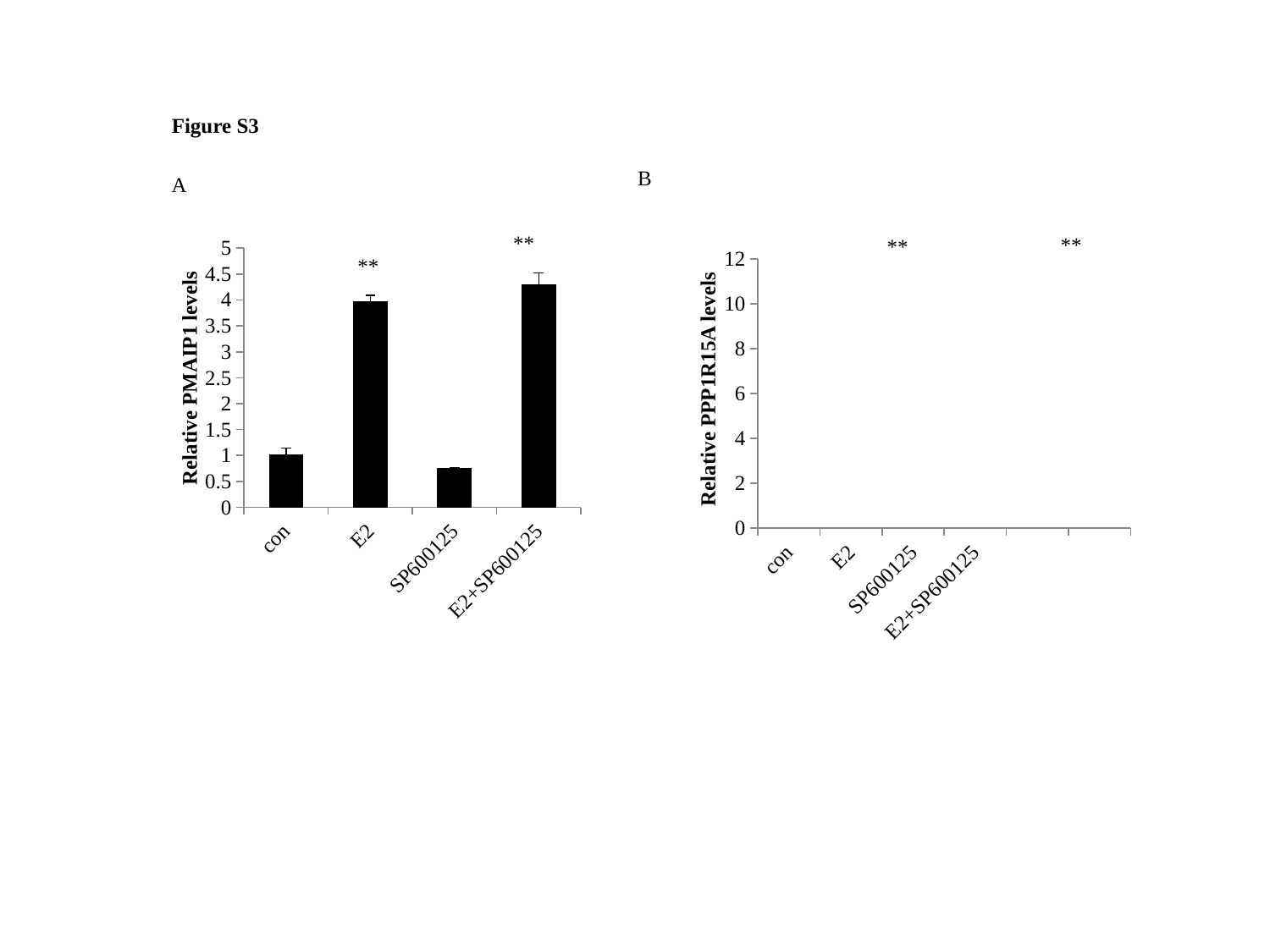
What is the y-axis label of chart A? Relative PMAIP1 levels In chart A (Relative PMAIP1 levels), which is larger, the value for E2 or the value for con? E2 In chart A (Relative PMAIP1 levels), is the value for E2 greater or less than 4.5? less In chart A (Relative PMAIP1 levels), how many categories are shown on the x axis? 4 In chart A (Relative PMAIP1 levels), which is larger, the value for con or the value for SP600125? con In chart A (Relative PMAIP1 levels), which category has the lowest bar? SP600125 In chart A (Relative PMAIP1 levels), which category has the highest bar? E2+SP600125 In chart A (Relative PMAIP1 levels), is the value for E2 greater or less than 3? greater In chart A (Relative PMAIP1 levels), is the value for E2+SP600125 greater or less than 4? greater What kind of chart is chart A (Relative PMAIP1 levels)? bar chart What is the y-axis label of chart B? Relative PPP1R15A levels